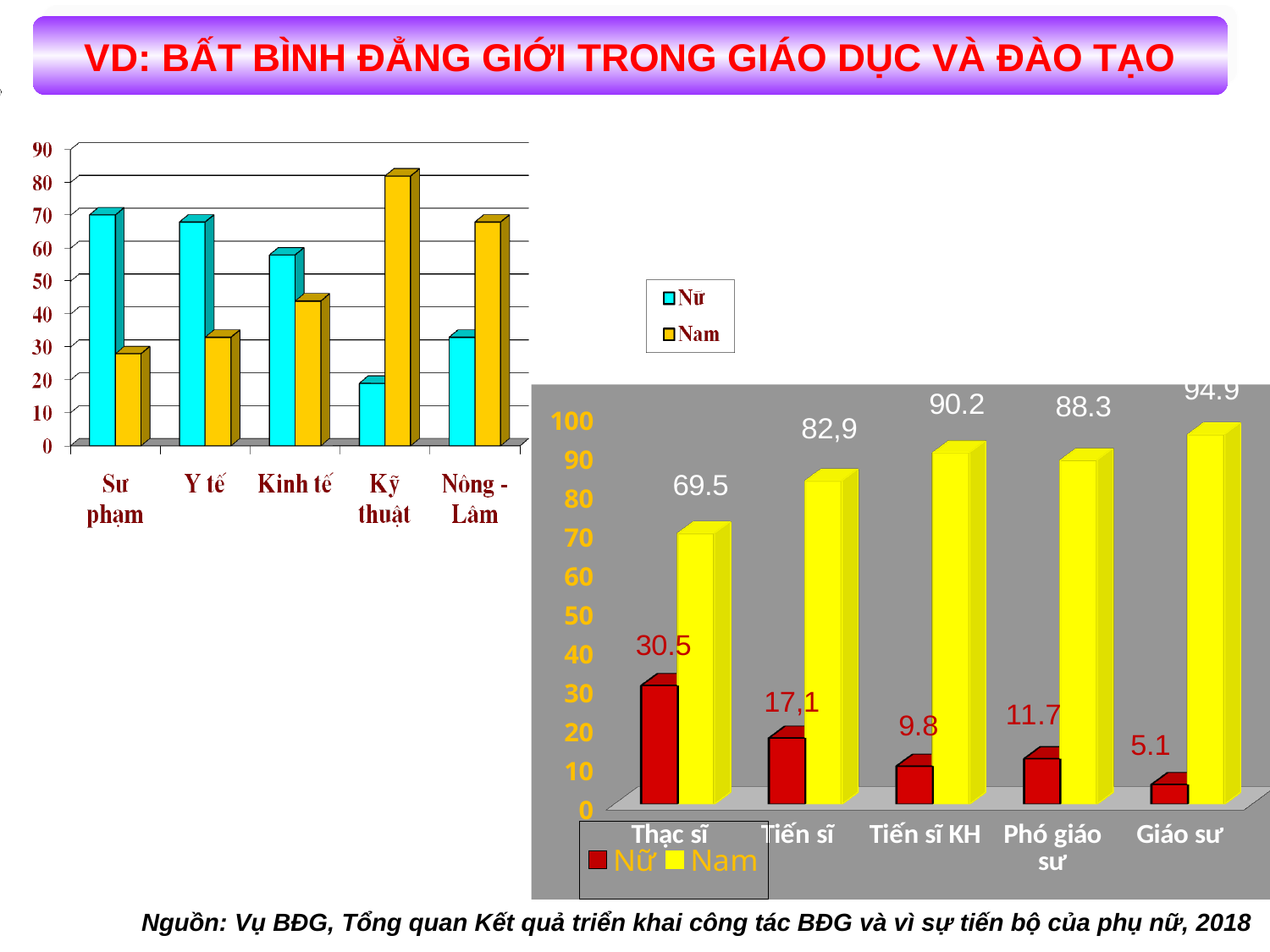
In the bottom-right chart, what is the Nam value for Giáo sư? 94.9 How many series does the legend of the top-left chart list? 2 What kind of chart is the top-left chart? Bar chart In the bottom-right chart, is the Nữ value for Thạc sĩ or for Tiến sĩ larger? Thạc sĩ In the bottom-right chart, what is the difference between the Nam and Nữ values for Phó giáo sư? 76.6 In the bottom-right chart, which category has the lowest Nữ value? Giáo sư In the bottom-right chart, what is the Nữ value for Tiến sĩ KH? 9.8 In the bottom-right chart, which category has the highest Nam value? Giáo sư In the top-left chart, is the Nam value for Kỹ thuật greater or less than 70? greater In the bottom-right chart, what is the Nữ value for Thạc sĩ? 30.5 In the top-left chart, is the Nữ value for Kỹ thuật greater or less than 30? less How many categories does the bottom-right chart show? 5